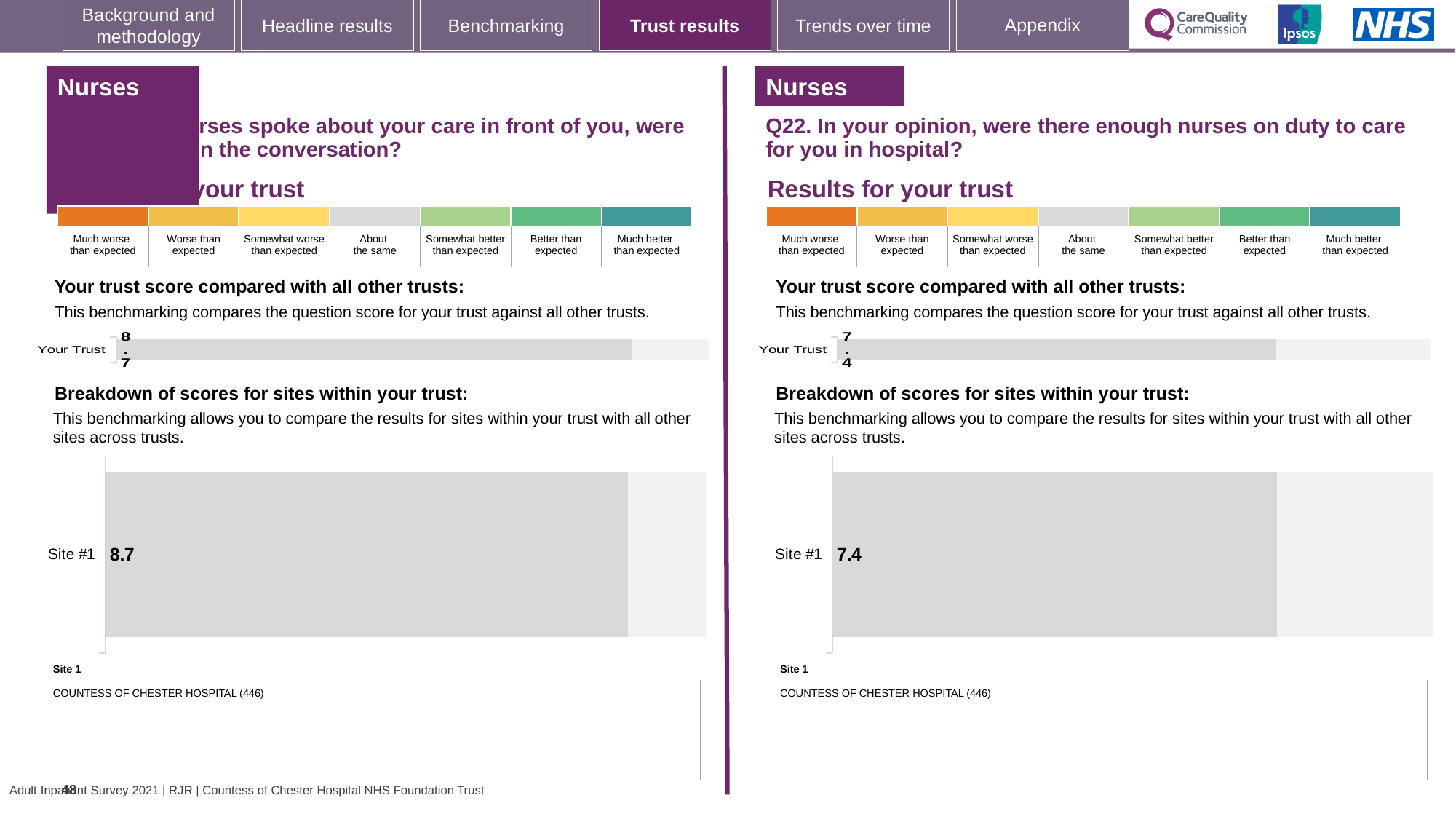
What type of chart is used to show the Site #1 score on the right half of the slide (Q22)? Bar chart On the left half of the slide, what is the score shown for Site #1 in the breakdown of scores for sites within your trust? 8.7 What type of chart is used to show the 'Your Trust' score on the left half of the slide? Bar chart How many sites are shown in the breakdown of scores chart on the right half of the slide (Q22)? 1 How many categories does the colour scale above the trust score charts contain, from 'Much worse than expected' to 'Much better than expected'? 7 Which hospital is listed as Site 1 beneath the breakdown chart on the right half of the slide (Q22)? COUNTESS OF CHESTER HOSPITAL (446) Which Site #1 score is larger: the one on the left half of the slide or the one on the right half (Q22)? Left half (8.7) On the right half of the slide (Q22), what is the value shown for 'Your Trust' in the trust score comparison chart? 7.4 On the right half of the slide (Q22, enough nurses on duty), what is the score shown for Site #1 in the breakdown of scores for sites within your trust? 7.4 What is the difference between the Site #1 score on the left half of the slide (8.7) and the Site #1 score on the right half (7.4)? 1.3 How many sites are shown in the breakdown of scores chart on the left half of the slide? 1 On the left half of the slide, what is the value shown for 'Your Trust' in the trust score comparison chart? 8.7